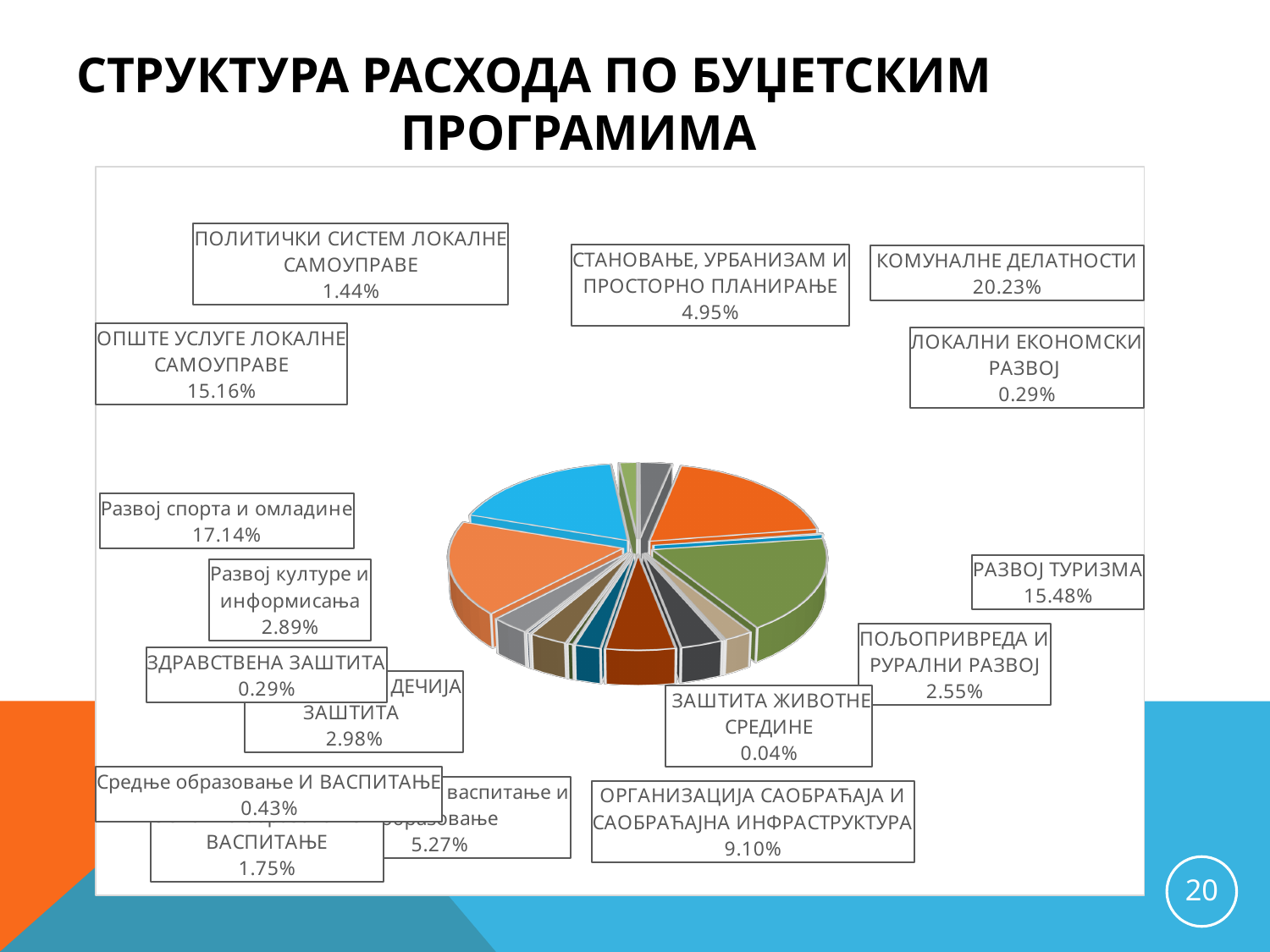
What percentage is shown for РАЗВОЈ ТУРИЗМА? 15.48% What type of chart is shown on the slide? Pie chart What is the title of the slide containing the chart? СТРУКТУРА РАСХОДА ПО БУЏЕТСКИМ ПРОГРАМИМА What is the value for ОРГАНИЗАЦИЈА САОБРАЋАЈА И САОБРАЋАЈНА ИНФРАСТРУКТУРА? 9.10% What is the value shown for Развој спорта и омладине? 17.14% What is the value shown for ПОЉОПРИВРЕДА И РУРАЛНИ РАЗВОЈ? 2.55% What share of expenditure goes to КОМУНАЛНЕ ДЕЛАТНОСТИ? 20.23% Which budget programme has the largest share of expenditure? КОМУНАЛНЕ ДЕЛАТНОСТИ What share is shown for СТАНОВАЊЕ, УРБАНИЗАМ И ПРОСТОРНО ПЛАНИРАЊЕ? 4.95% Which is larger: the share for РАЗВОЈ ТУРИЗМА or for ОПШТЕ УСЛУГЕ ЛОКАЛНЕ САМОУПРАВЕ? РАЗВОЈ ТУРИЗМА Which budget programme has the smallest share of expenditure? ЗАШТИТА ЖИВОТНЕ СРЕДИНЕ What is the difference in percentage points between КОМУНАЛНЕ ДЕЛАТНОСТИ and Развој спорта и омладине? 3.09